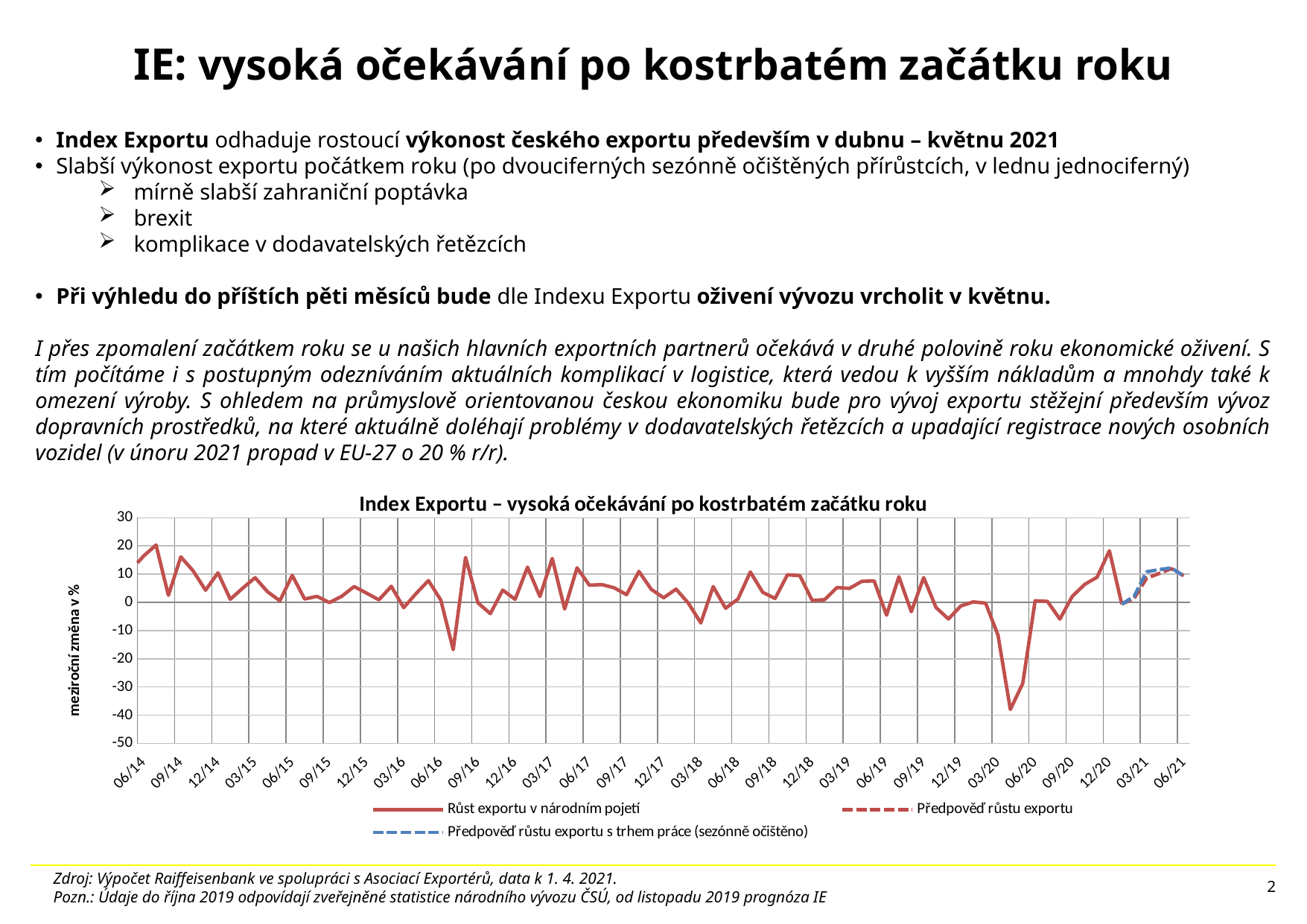
Does the solid line 'Růst exportu v národním pojetí' rise or fall between 03/20 and 06/20? rise What kind of chart is shown on the slide? line chart What is the highest value shown on the vertical axis of the chart? 30 How many series does the chart legend list? 3 What is the label of the vertical axis of the chart? meziroční změna v % What is the title of the chart? Index Exportu – vysoká očekávání po kostrbatém začátku roku Is the value of the solid line 'Růst exportu v národním pojetí' at 12/20 greater or less than 10? greater Is the lowest value of the solid line 'Růst exportu v národním pojetí' greater or less than -30? less How many labels are shown on the x axis of the chart? 29 Does the solid line 'Růst exportu v národním pojetí' rise or fall between 06/20 and 12/20? rise Which is larger on the solid line: the value at 12/20 or the value at 06/20? 12/20